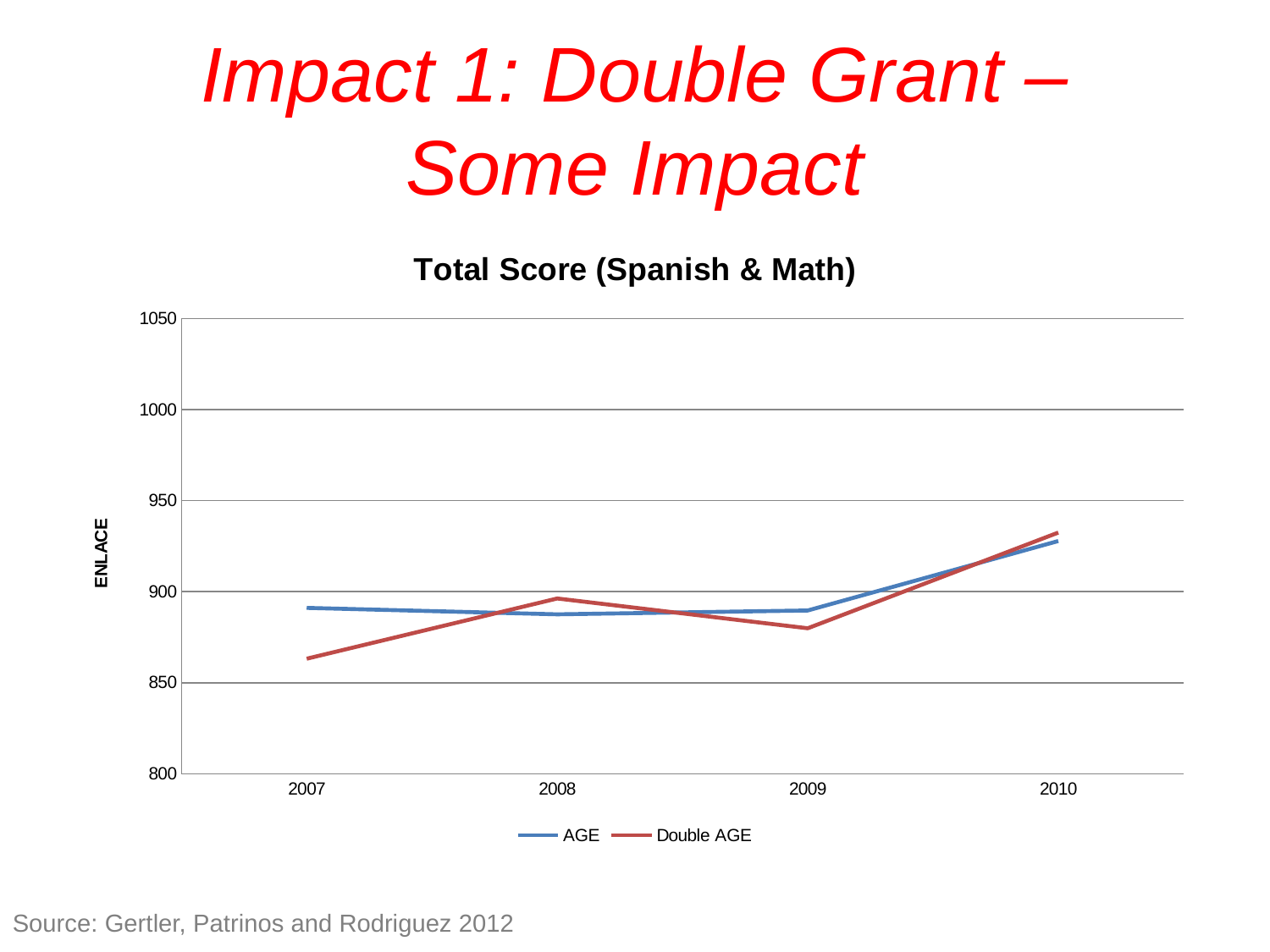
How many years are shown on the x axis? 4 In which year is the Double AGE series at its lowest? 2007 What is the title of the chart? Total Score (Spanish & Math) Is the value for AGE in 2010 greater or less than 900? greater In 2007, which series has the higher value, AGE or Double AGE? AGE Is the value for Double AGE in 2007 greater or less than 900? less Does the Double AGE series rise or fall from 2009 to 2010? rise What kind of chart is shown on the slide? line chart What is the label on the vertical axis? ENLACE In 2008, which series has the higher value, AGE or Double AGE? Double AGE How many series does the legend list? 2 Is the value for Double AGE in 2009 greater or less than 900? less